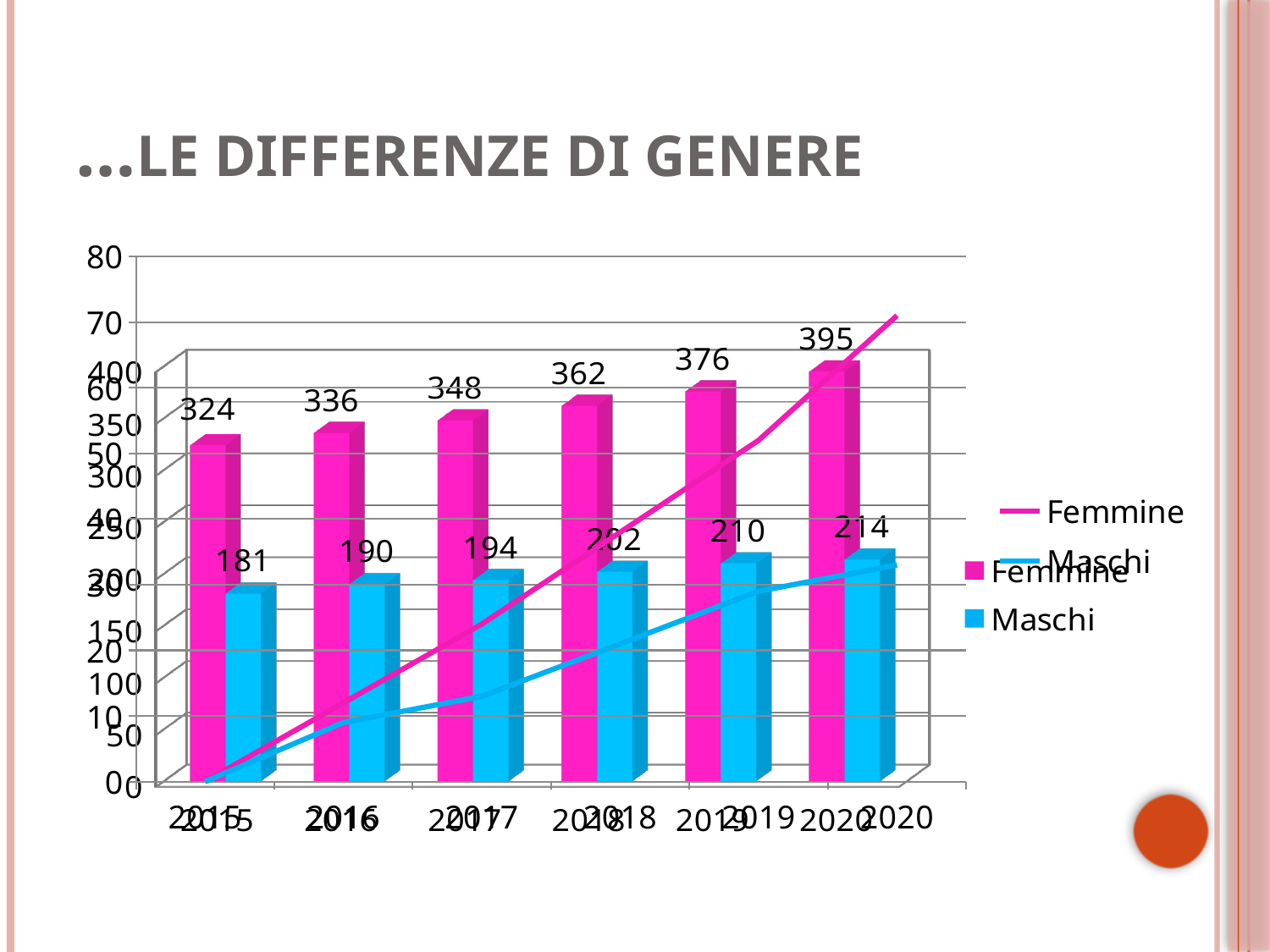
In the bar chart, what is the value for Femmine in 2018? 362 How many series does the bar chart's legend list? 2 How many years are shown on the x axis of the bar chart? 6 In the bar chart, which is larger in 2019: the Femmine value or the Maschi value? Femmine In the bar chart, what is the difference between the Femmine values for 2020 and 2015? 71 In the bar chart, which year has the highest Femmine value? 2020 In the bar chart, what is the value for Femmine in 2015? 324 In the bar chart, what is the difference between the Femmine and Maschi values in 2020? 181 In the bar chart, what is the value for Maschi in 2020? 214 In the bar chart, do the Maschi values rise or fall from 2015 to 2020? rise In the bar chart, what is the value for Maschi in 2017? 194 In the bar chart, which year has the lowest Maschi value? 2015